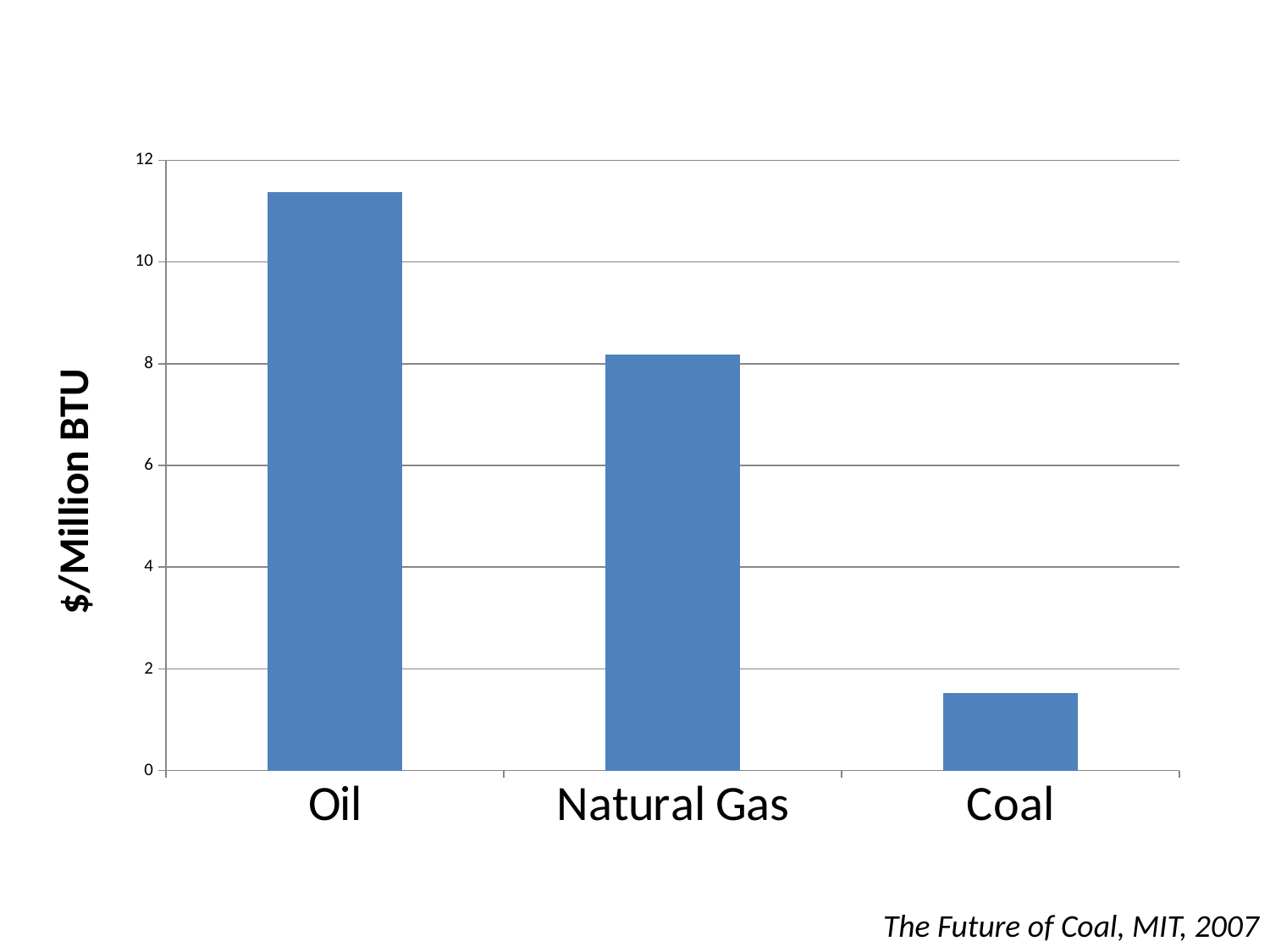
What kind of chart is shown on the slide? bar chart Which is larger, the value for Oil or the value for Natural Gas? Oil Do the values rise or fall from left to right across the categories? fall Is the value for Oil greater or less than 10? greater Which category has the lowest value? Coal How many categories are plotted on the chart? 3 What source is cited at the bottom of the slide? The Future of Coal, MIT, 2007 Is the value for Natural Gas greater or less than 8? greater Is the value for Coal greater or less than 2? less Which category has the highest value? Oil Which is larger, the value for Natural Gas or the value for Coal? Natural Gas What is the label on the vertical axis? $/Million BTU